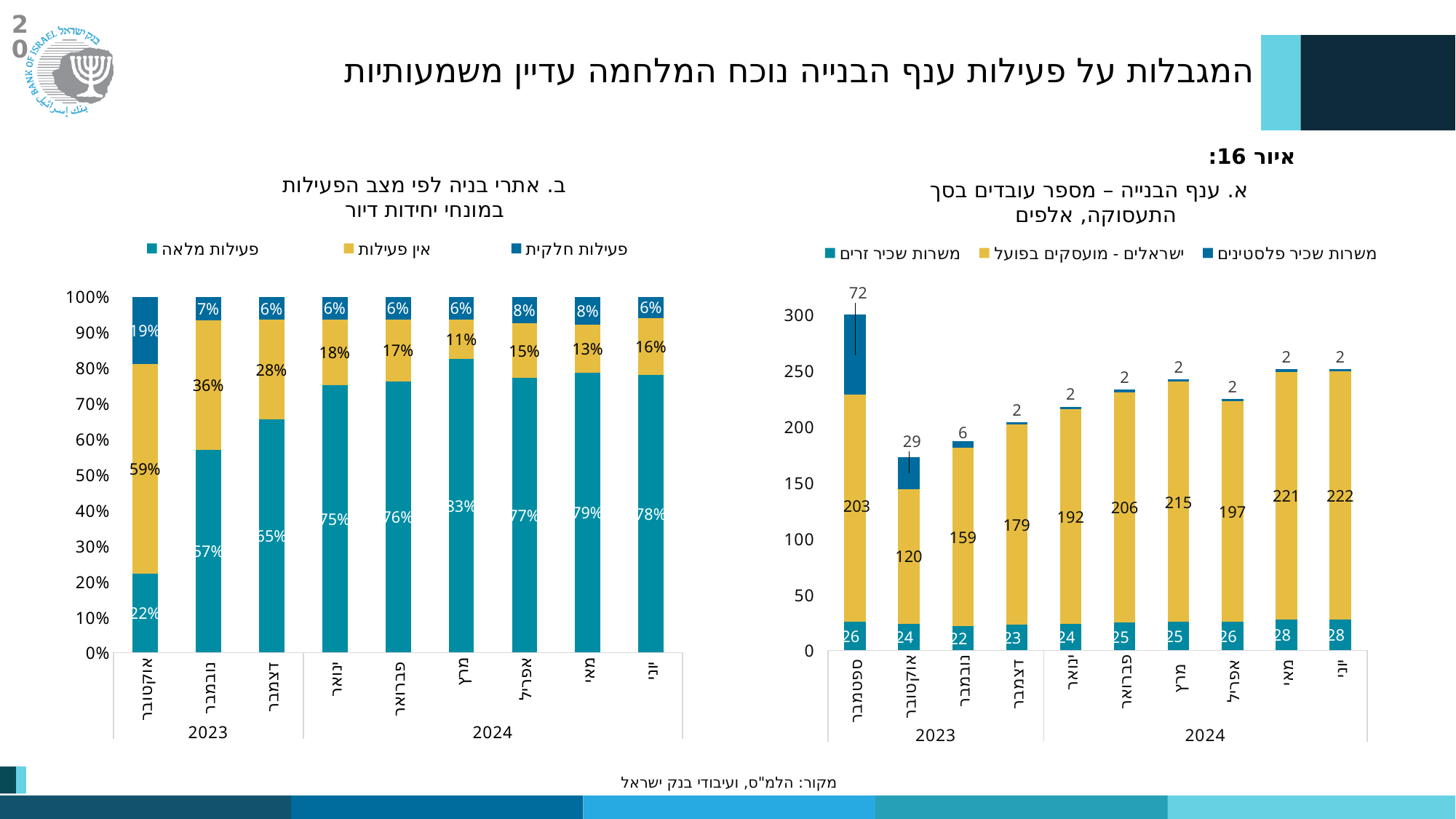
In the right chart (א. ענף הבנייה – מספר עובדים בסך התעסוקה, אלפים), what is the total of the stacked bar for יוני 2024? 252 In the left chart (ב. אתרי בניה לפי מצב הפעילות), is the share of פעילות מלאה larger in נובמבר 2023 or in דצמבר 2023? דצמבר 2023 What kind of chart is the left chart (ב. אתרי בניה לפי מצב הפעילות)? Stacked bar chart In the right chart (א. ענף הבנייה – מספר עובדים בסך התעסוקה, אלפים), how many months are shown on the x axis? 10 In the right chart (א. ענף הבנייה – מספר עובדים בסך התעסוקה, אלפים), how many series does the legend list? 3 In the right chart (א. ענף הבנייה – מספר עובדים בסך התעסוקה, אלפים), what is the value for ישראלים - מועסקים בפועל in ספטמבר 2023? 203 In the right chart (א. ענף הבנייה – מספר עובדים בסך התעסוקה, אלפים), what is the difference between the ישראלים - מועסקים בפועל values for ספטמבר 2023 and אוקטובר 2023? 83 In the left chart (ב. אתרי בניה לפי מצב הפעילות), what is the share of פעילות מלאה in מרץ 2024? 83% In the right chart (א. ענף הבנייה – מספר עובדים בסך התעסוקה, אלפים), what is the value for משרות שכיר פלסטינים in אוקטובר 2023? 29 In the left chart (ב. אתרי בניה לפי מצב הפעילות), which month has the highest share of אין פעילות? אוקטובר 2023 In the right chart (א. ענף הבנייה – מספר עובדים בסך התעסוקה, אלפים), which month has the lowest value for ישראלים - מועסקים בפועל? אוקטובר 2023 In the left chart (ב. אתרי בניה לפי מצב הפעילות), what is the difference between the פעילות מלאה shares in אוקטובר 2023 and ינואר 2024? 53%